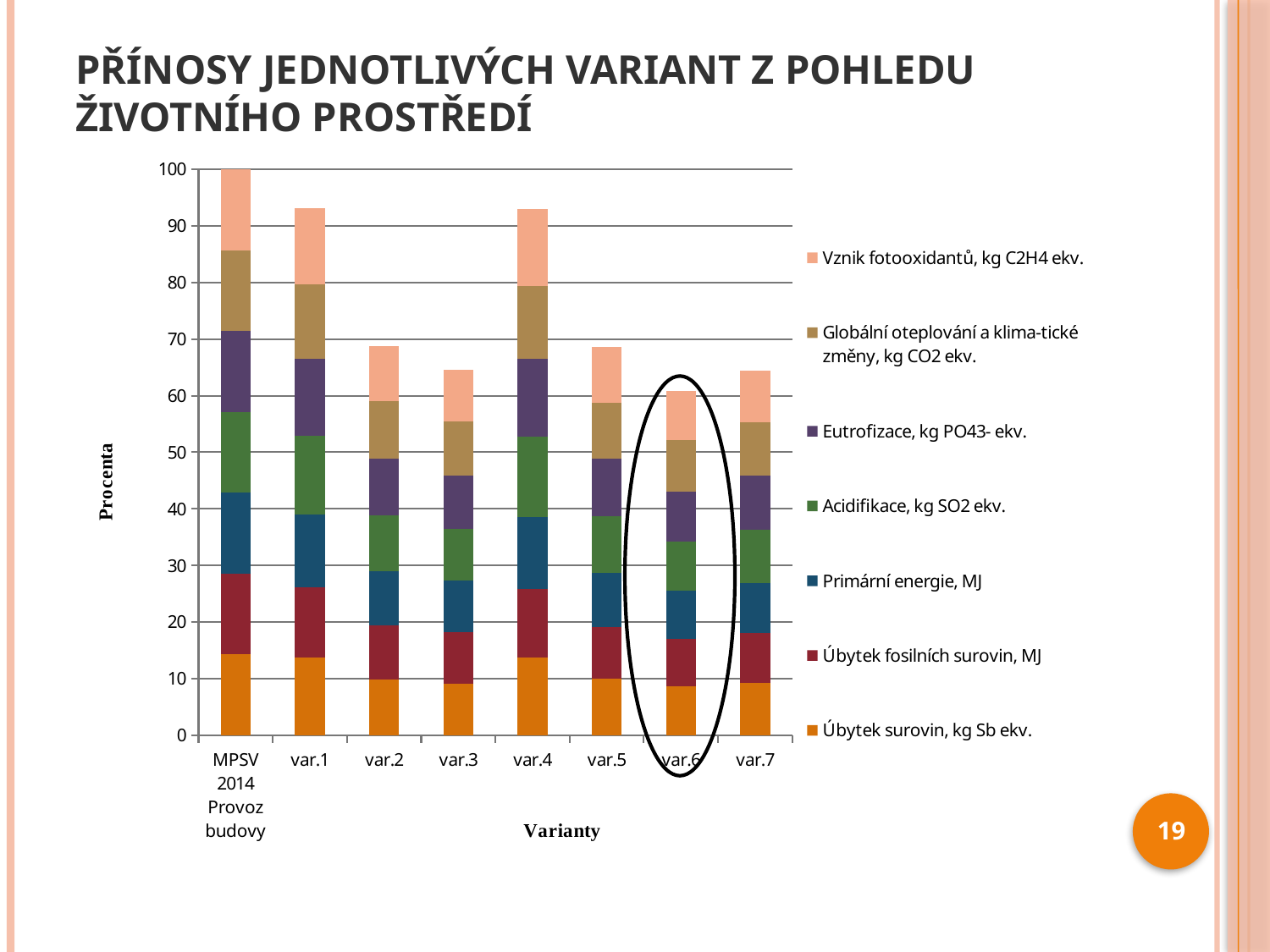
What is the total of the stacked bar for MPSV 2014 Provoz budovy? 100 Which has the larger total stacked bar, var.1 or var.2? var.1 Which has the larger total stacked bar, var.4 or var.5? var.4 Which category has the highest total stacked bar? MPSV 2014 Provoz budovy Which category on the x axis is circled on the slide? var.6 Is the total stacked bar for var.3 greater or less than 70? less Is the total stacked bar for var.1 greater or less than 90? greater Is the total stacked bar for var.6 greater or less than 70? less How many series does the chart's legend list? 7 Which category has the lowest total stacked bar? var.6 What kind of chart is shown on the slide? Stacked bar chart How many categories are shown along the x axis of the chart? 8